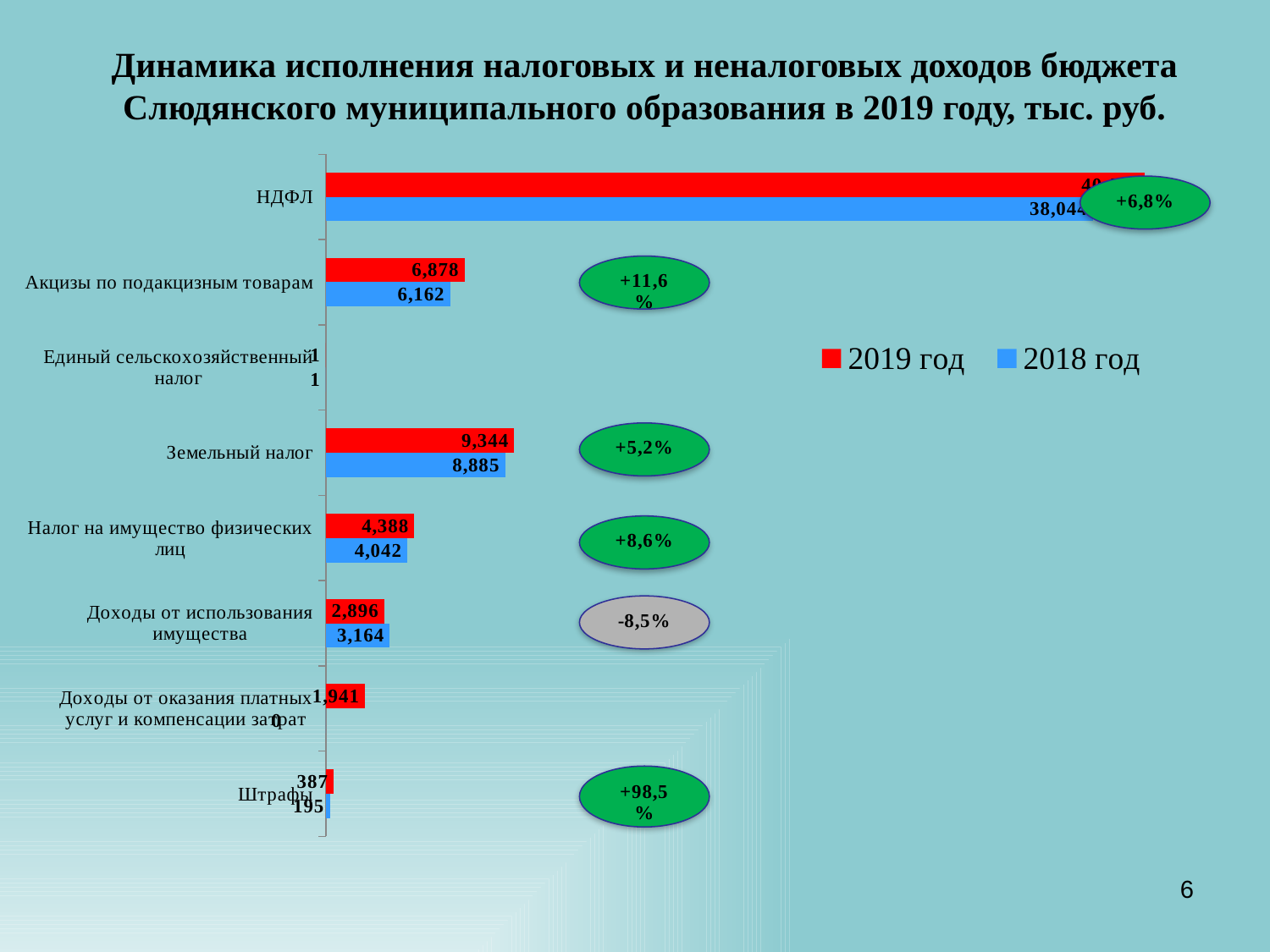
What type of chart is shown on the slide? bar chart What is the 2018 год value for Доходы от использования имущества? 3,164 What is the 2019 год value for Акцизы по подакцизным товарам? 6,878 Which category has the highest 2019 год value? НДФЛ What is the difference between the 2019 год and 2018 год values for Земельный налог? 459 What is the 2019 год value for Налог на имущество физических лиц? 4,388 How many series does the legend list? 2 What is the 2018 год value for Земельный налог? 8,885 What is the 2019 год value for Штрафы? 387 For Доходы от использования имущества, which is larger: the 2019 год value or the 2018 год value? 2018 год How many categories are shown on the chart? 8 What percentage change is shown in the oval next to Штрафы? +98,5%